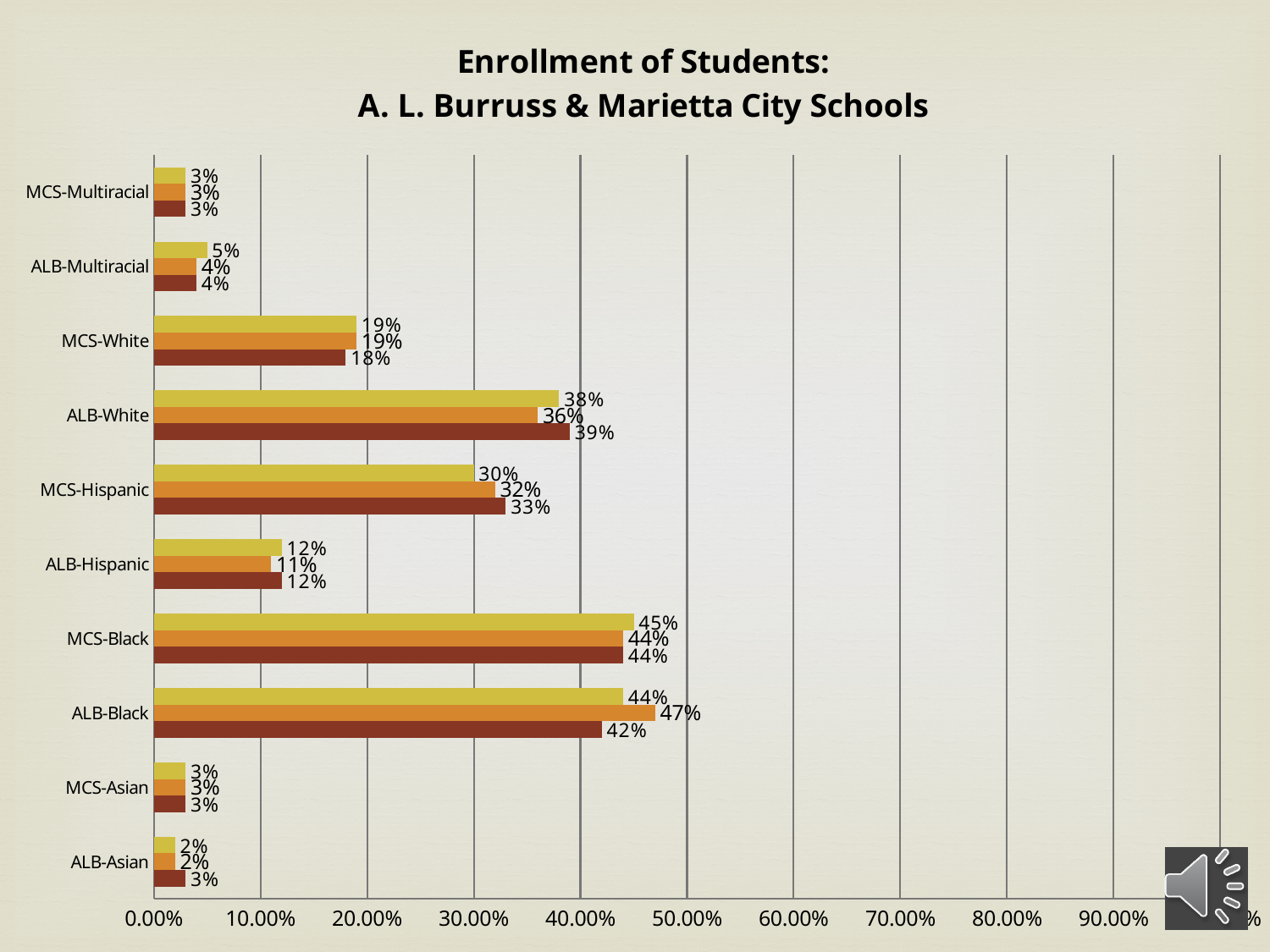
What is the value of the top (yellow) bar for ALB-White? 38% What kind of chart is shown on the slide? bar chart What is the title of the chart? Enrollment of Students: A. L. Burruss & Marietta City Schools What is the value of the middle (orange) bar for ALB-Black? 47% What is the value of the bottom (dark red) bar for MCS-Hispanic? 33% What is the highest value labelled anywhere on the chart? 47% Which has the larger top (yellow) bar value, MCS-Black or ALB-Black? MCS-Black What is the difference between the top (yellow) bar for ALB-White and the top (yellow) bar for MCS-White? 19 percentage points How many categories are listed on the vertical axis of the chart? 10 What is the value of the middle (orange) bar for ALB-Hispanic? 11% What is the difference between the middle (orange) bar and the bottom (dark red) bar for ALB-Black? 5 percentage points Is the value of the bottom (dark red) bar for ALB-White greater or less than 30.00%? greater